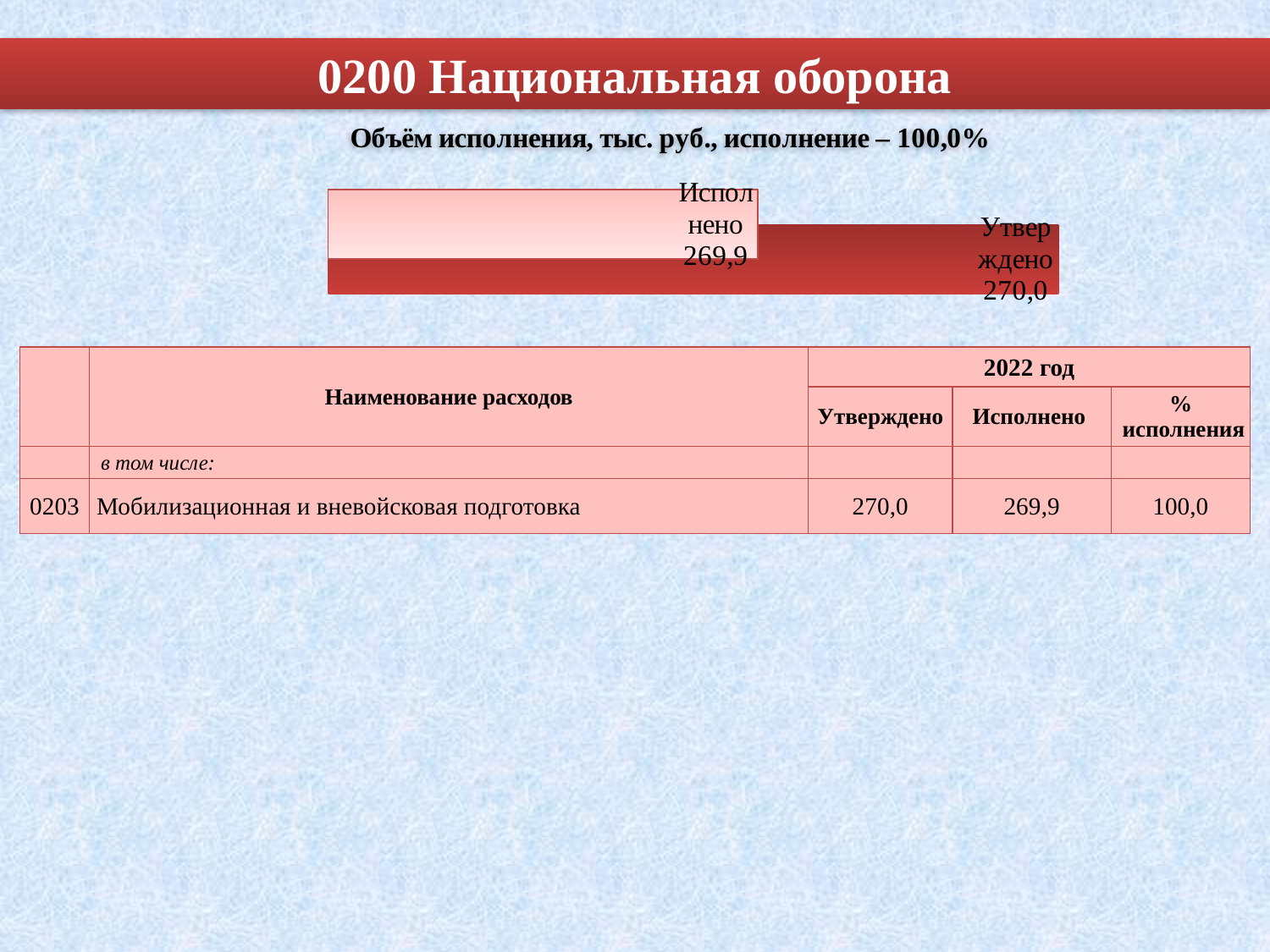
According to the data labels, which bar has the larger value, Утверждено or Исполнено? Утверждено What colour is the Утверждено bar in the chart? dark red What kind of chart is shown on the slide? bar chart How many bars are plotted in the chart? 2 What is the title of the chart? Объём исполнения, тыс. руб., исполнение – 100,0% What value is shown for Исполнено in the bar chart? 269,9 According to the data labels, which bar has the smaller value? Исполнено What value is shown for Утверждено in the bar chart? 270,0 What is the difference between the Утверждено value and the Исполнено value in the chart? 0,1